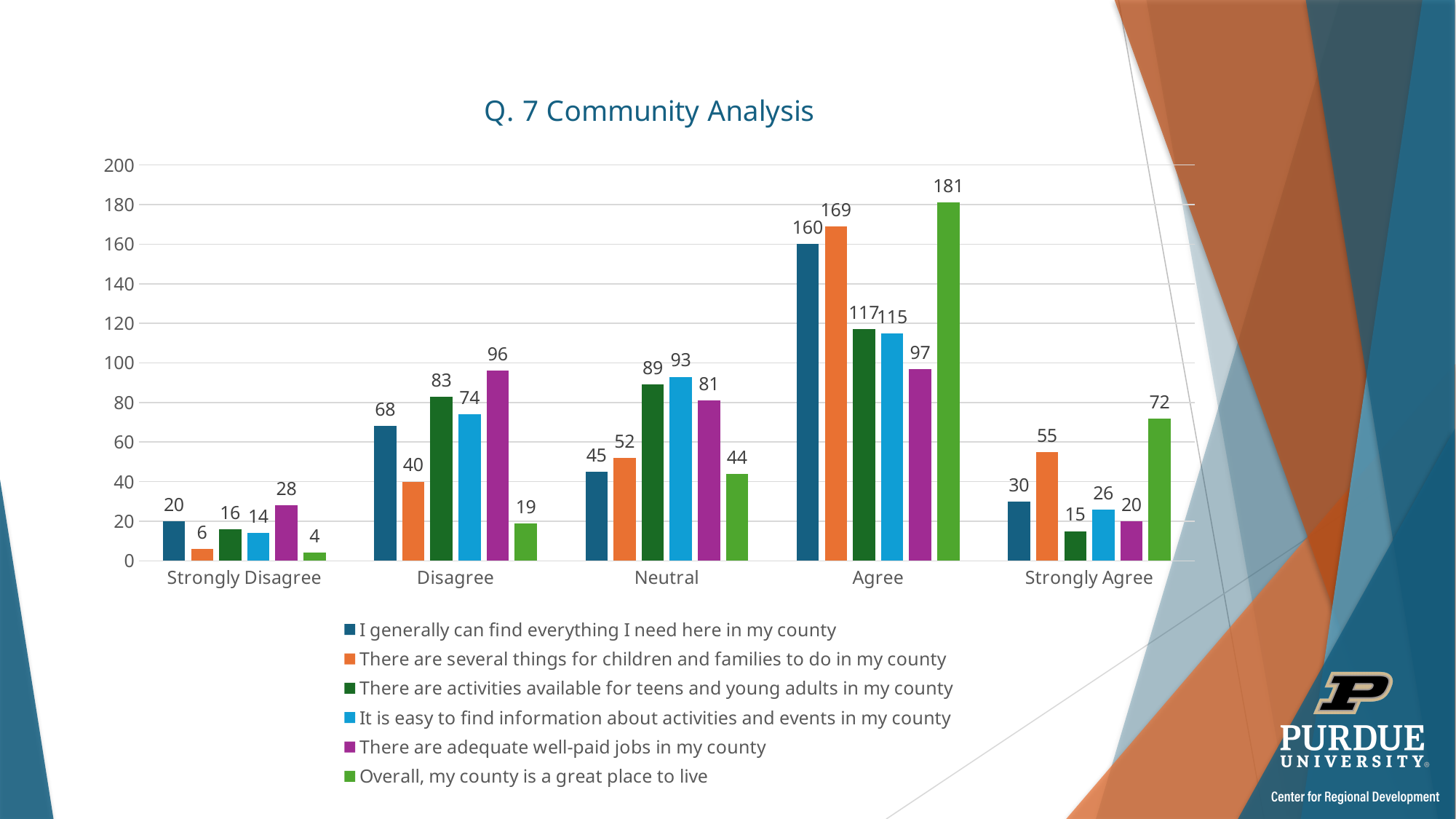
How many response categories are shown on the x axis? 5 What is the value for "There are several things for children and families to do in my county" in the Strongly Agree category? 55 Is the value for "There are adequate well-paid jobs in my county" in the Agree category greater or less than 100? less What type of chart is shown on the slide? bar chart Which series has the lowest value in the Strongly Disagree category? Overall, my county is a great place to live Which series has the highest value in the Neutral category? It is easy to find information about activities and events in my county What is the title of the chart? Q. 7 Community Analysis In the Disagree category, which is larger: the value for "There are activities available for teens and young adults in my county" or the value for "It is easy to find information about activities and events in my county"? There are activities available for teens and young adults in my county What is the difference between the Agree values for "There are several things for children and families to do in my county" and "I generally can find everything I need here in my county"? 9 What is the value for "There are adequate well-paid jobs in my county" in the Disagree category? 96 How many series does the legend list? 6 What is the value for "Overall, my county is a great place to live" in the Agree category? 181